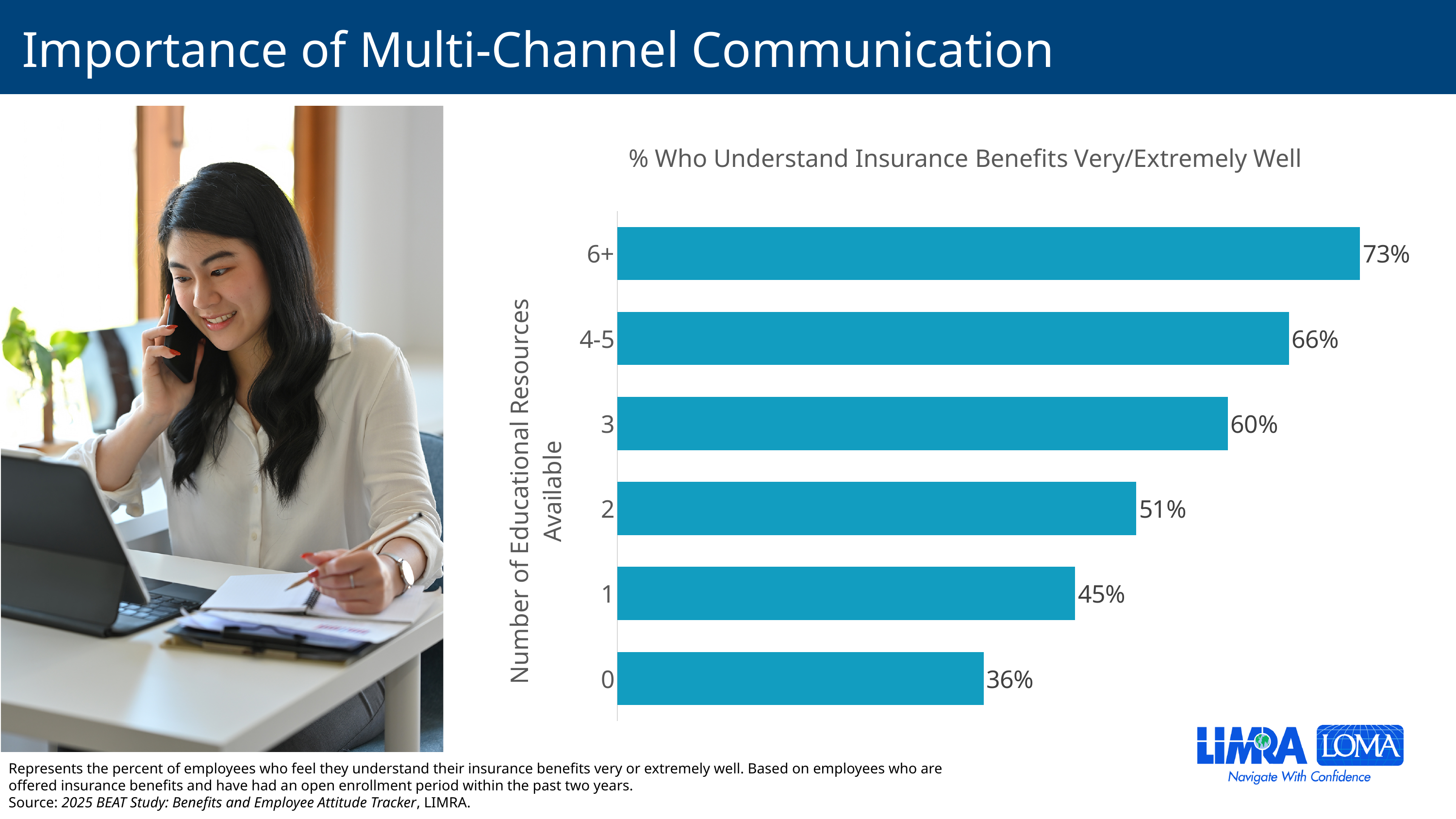
What type of chart is shown on the slide? Bar chart What is the title of the chart? % Who Understand Insurance Benefits Very/Extremely Well How many categories of educational resources are shown on the chart? 6 What is the difference between the values for 4-5 resources and 2 resources? 15 Which number of educational resources category has the highest percentage? 6+ What is the value shown for employees with 0 educational resources available? 36% Do the percentages increase or decrease as the number of educational resources available increases? Increase Which number of educational resources category has the lowest percentage? 0 What percentage of employees with 6+ educational resources available understand their insurance benefits very/extremely well? 73% What is the difference in percentage points between the 6+ category and the 0 category? 37 What percentage is shown for the '3' educational resources category? 60% Which has a higher value: 1 educational resource or 2 educational resources? 2